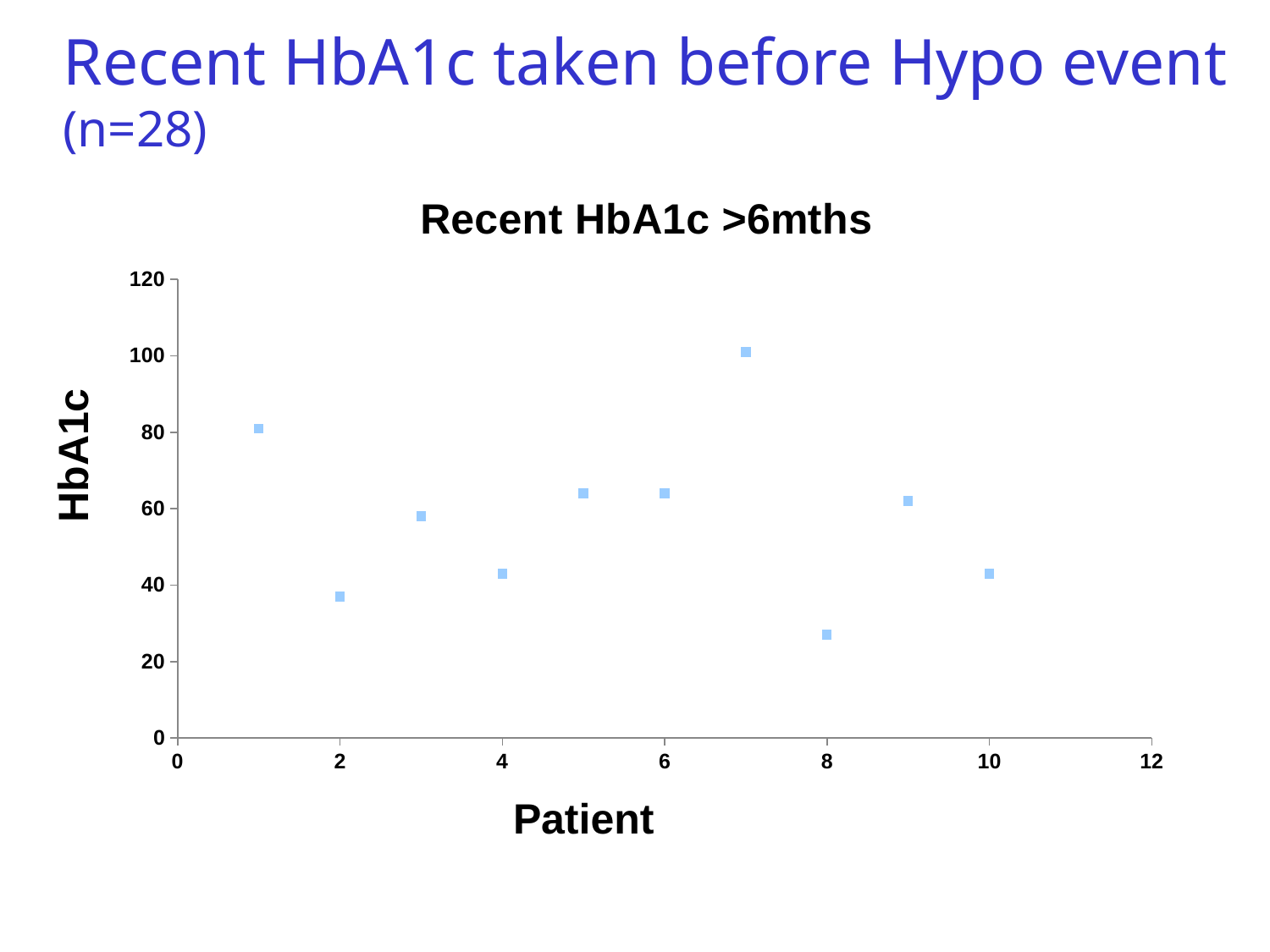
How many data points are plotted in the chart? 10 What is the title of the chart? Recent HbA1c >6mths Is the HbA1c value for patient 1 greater or less than 60? greater What kind of chart is shown on the slide? scatter chart Is the HbA1c value for patient 8 greater or less than 40? less Is the HbA1c value for patient 2 greater or less than 40? less Which patient has the lowest HbA1c value? Patient 8 What is the label of the x axis? Patient Which patient has the highest HbA1c value? Patient 7 Which has the larger HbA1c value, patient 9 or patient 10? Patient 9 Which has the larger HbA1c value, patient 1 or patient 2? Patient 1